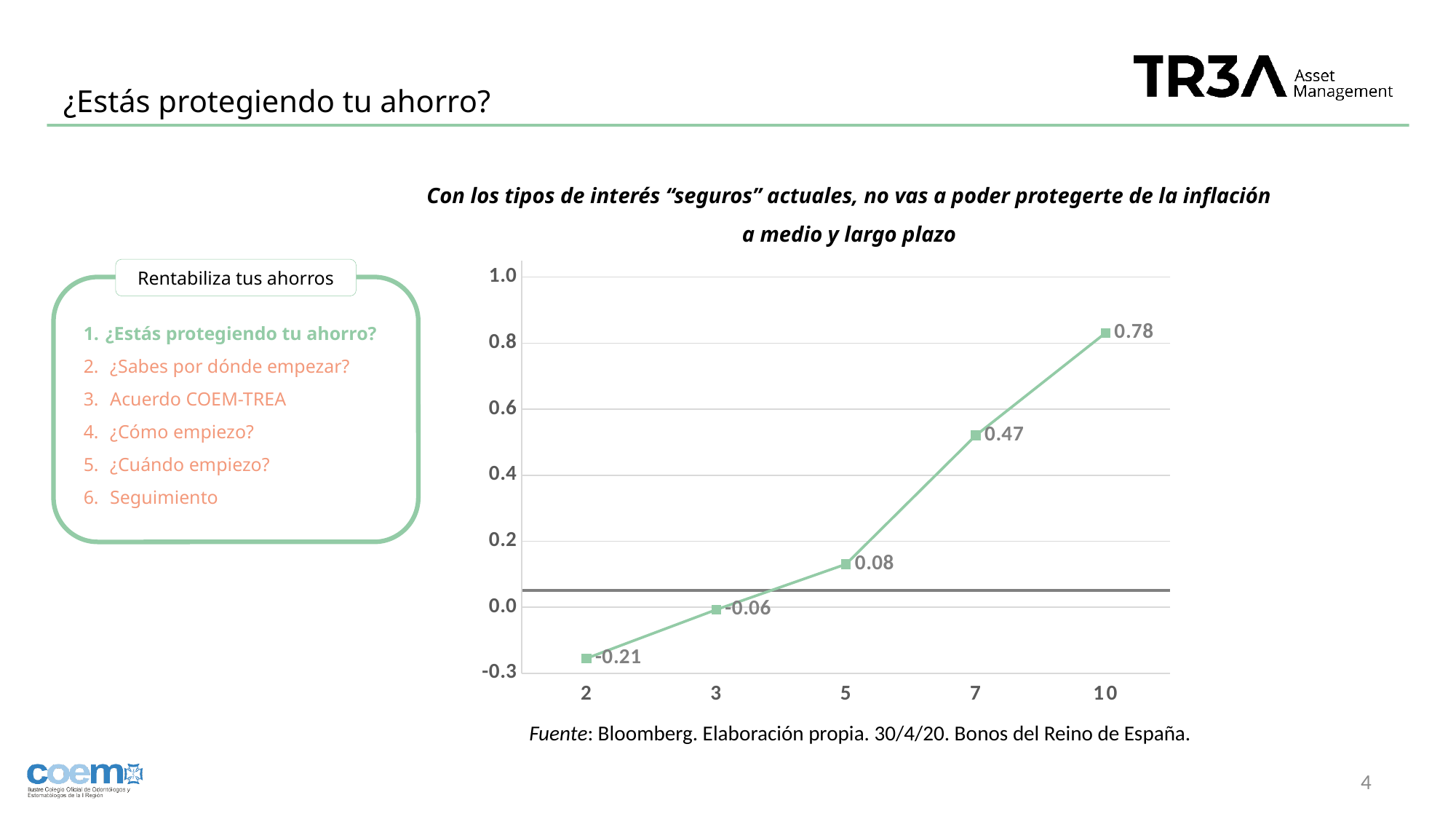
What is the value plotted at x = 5? 0.08 Which is larger, the value at x = 3 or the value at x = 5? the value at x = 5 What is the value plotted at x = 2? -0.21 What is the difference between the values at x = 10 and x = 7? 0.31 Which x-axis category has the lowest value? 2 Do the values rise or fall as you move along the x axis from 2 to 10? rise Which x-axis category has the highest value? 10 What is the value plotted at x = 10? 0.78 What kind of chart is shown on the slide? line chart How many data points are plotted on the line? 5 What is the value plotted at x = 7? 0.47 What is the source cited below the chart? Bloomberg